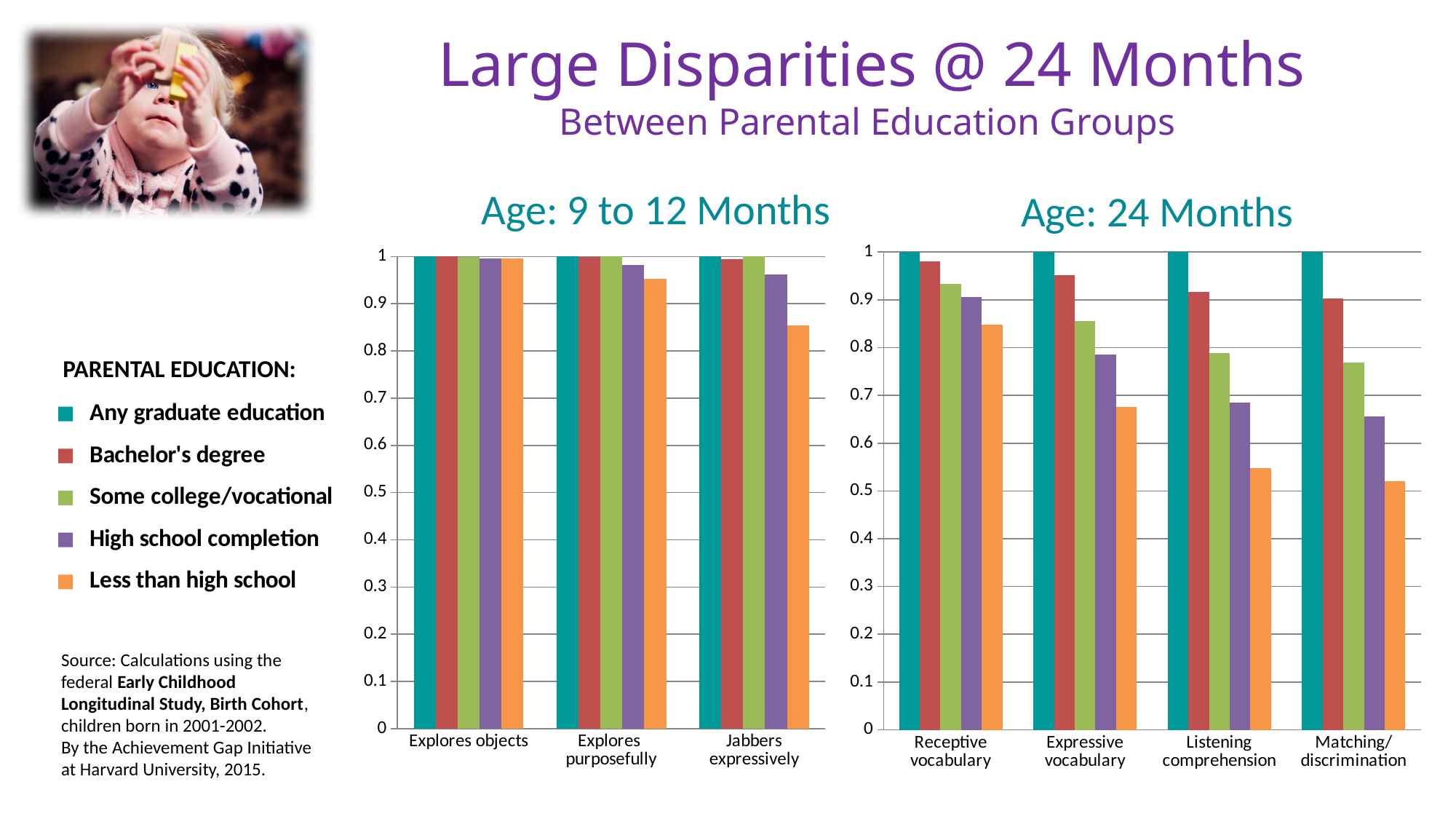
How many categories are shown on the x axis of the "Age: 9 to 12 Months" chart? 3 What kind of chart is the "Age: 24 Months" chart? bar chart In the "Age: 24 Months" chart, what is the value for Any graduate education in Receptive vocabulary? 1 In the "Age: 24 Months" chart, which parental education group has the lowest value for Matching/discrimination? Less than high school How many categories are shown on the x axis of the "Age: 24 Months" chart? 4 In the "Age: 24 Months" chart, do the Less than high school values rise or fall from left to right across the categories? fall In the "Age: 9 to 12 Months" chart, is the value for Less than high school in Jabbers expressively greater or less than 0.8? greater How many parental education groups does the legend list for the charts? 5 In the "Age: 24 Months" chart, is the Less than high school value larger for Receptive vocabulary or Expressive vocabulary? Receptive vocabulary In the "Age: 24 Months" chart, is the value for Less than high school in Matching/discrimination greater or less than 0.6? less What is the title of the left chart on the slide? Age: 9 to 12 Months In the "Age: 24 Months" chart, is the value for Some college/vocational in Matching/discrimination greater or less than 0.8? less